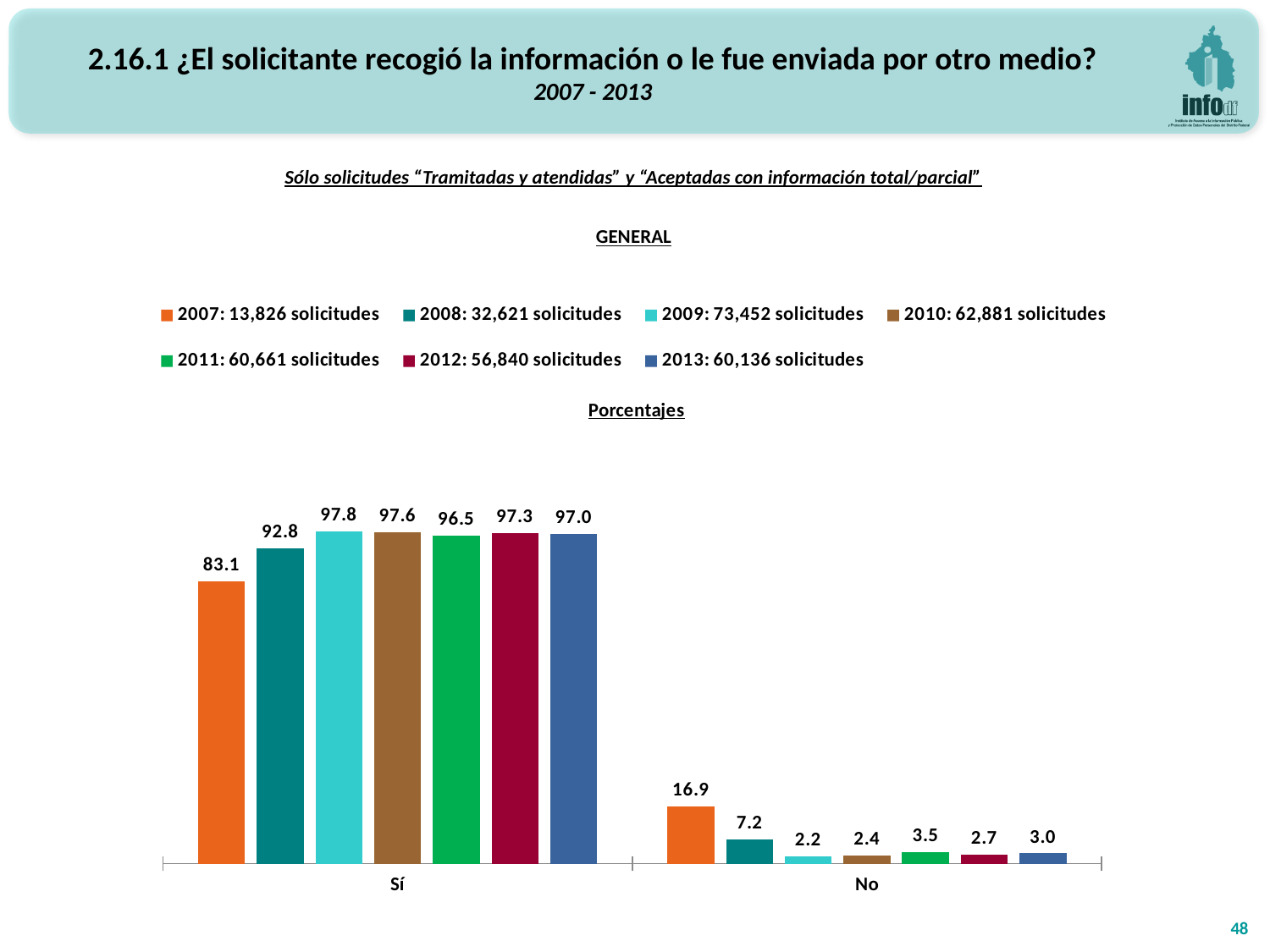
How many series does the legend list? 7 Which year has the lowest value in the "No" category? 2009 What is the value for 2013 in the "Sí" category? 97.0 What is the value for 2009 in the "No" category? 2.2 What kind of chart is shown on the slide? Bar chart What is the value for 2007 in the "Sí" category? 83.1 What is the difference between the 2007 and 2008 values in the "Sí" category? 9.7 What is the total of the 2010 values across the "Sí" and "No" categories? 100.0 Which year has the highest value in the "Sí" category? 2009 How many categories are shown on the x axis? 2 According to the legend, how many solicitudes were there in 2009? 73,452 Which is larger in the "No" category: the value for 2011 or the value for 2012? 2011